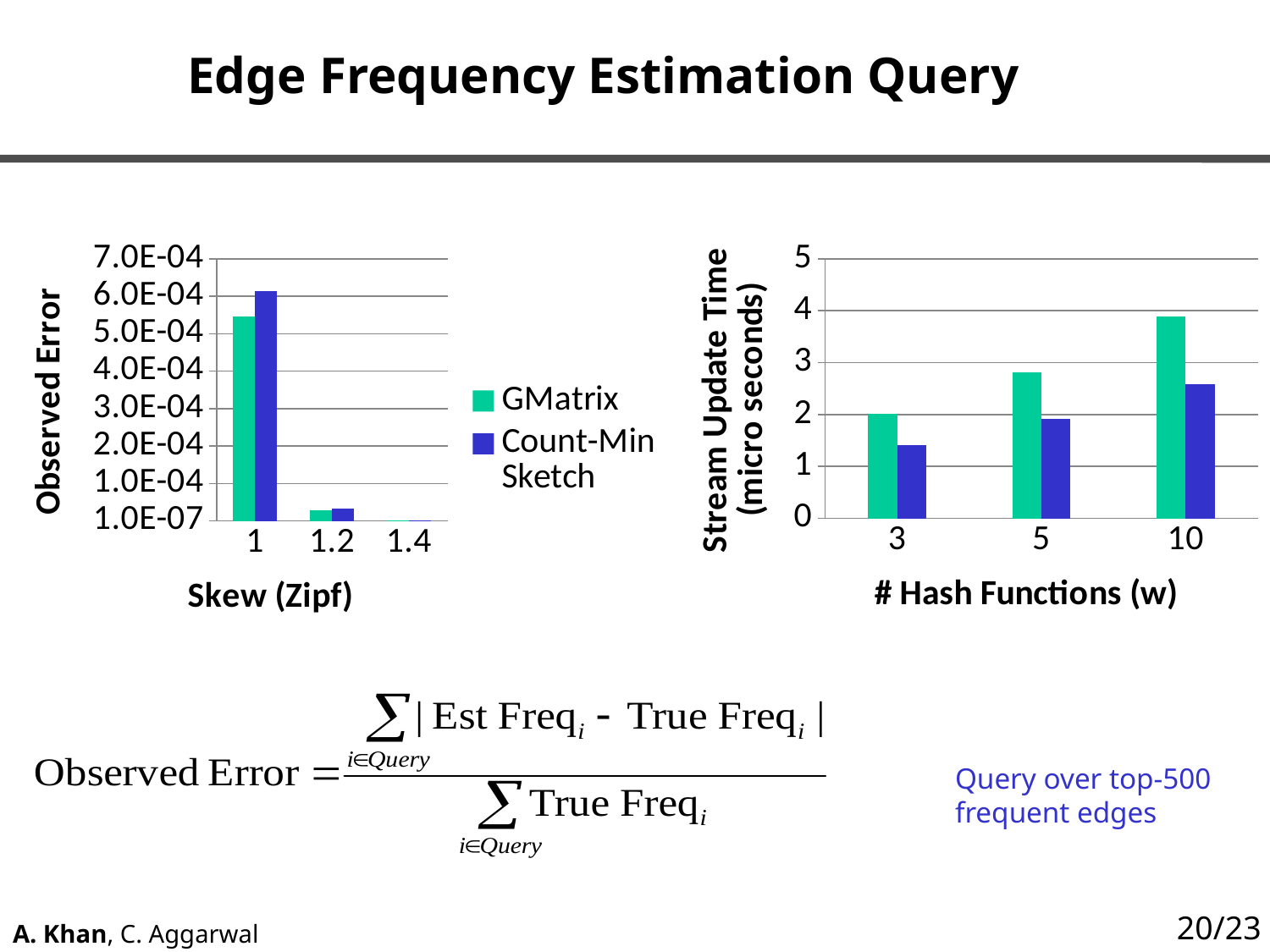
How many series does the legend list? 2 In the left chart (Observed Error), at skew 1, which series has the larger observed error, GMatrix or Count-Min Sketch? Count-Min Sketch What is the x-axis label of the right chart? # Hash Functions (w) What kind of chart is the left chart (Observed Error vs Skew)? bar chart In the right chart (Stream Update Time), how many values of # Hash Functions (w) are shown on the x axis? 3 In the right chart (Stream Update Time), does the GMatrix update time rise or fall as the number of hash functions increases? rise In the left chart (Observed Error), how many skew values are shown on the x axis? 3 In the right chart (Stream Update Time), at which number of hash functions is the GMatrix update time highest? 10 In the left chart (Observed Error), is the GMatrix value at skew 1 greater or less than 5.0E-04? greater